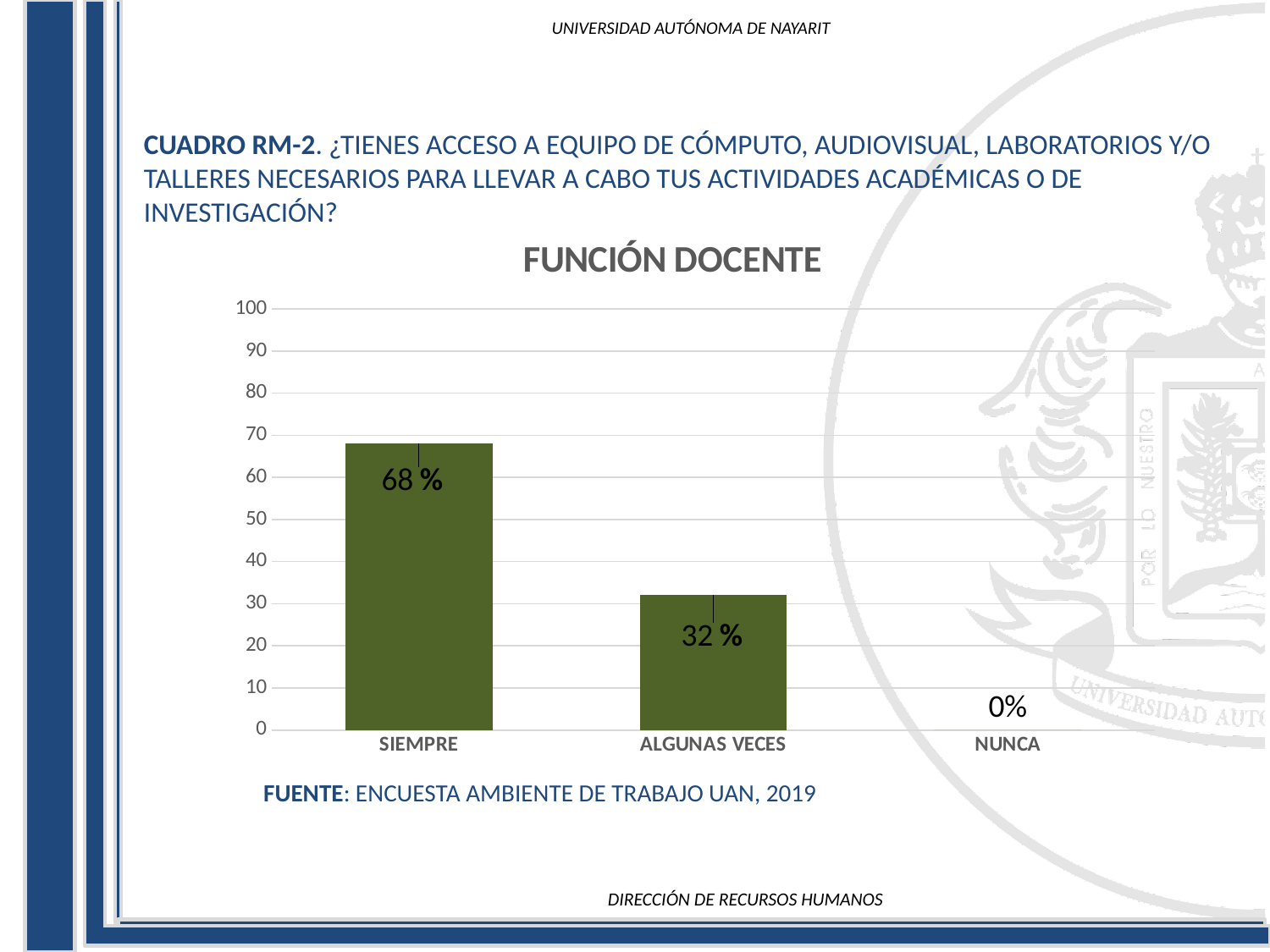
What kind of chart is this? bar chart Is the value for ALGUNAS VECES greater or less than 40? less What is the value for ALGUNAS VECES? 32 % Which category has the highest value? SIEMPRE What is the value for NUNCA? 0% Which category has the lowest value? NUNCA Do the values rise or fall from left to right along the x axis? fall What is the value for SIEMPRE? 68 % What is the title of the chart? FUNCIÓN DOCENTE How many categories are shown on the x axis? 3 What is the difference between the values for SIEMPRE and ALGUNAS VECES? 36 % Which is larger, the value for SIEMPRE or the value for ALGUNAS VECES? SIEMPRE